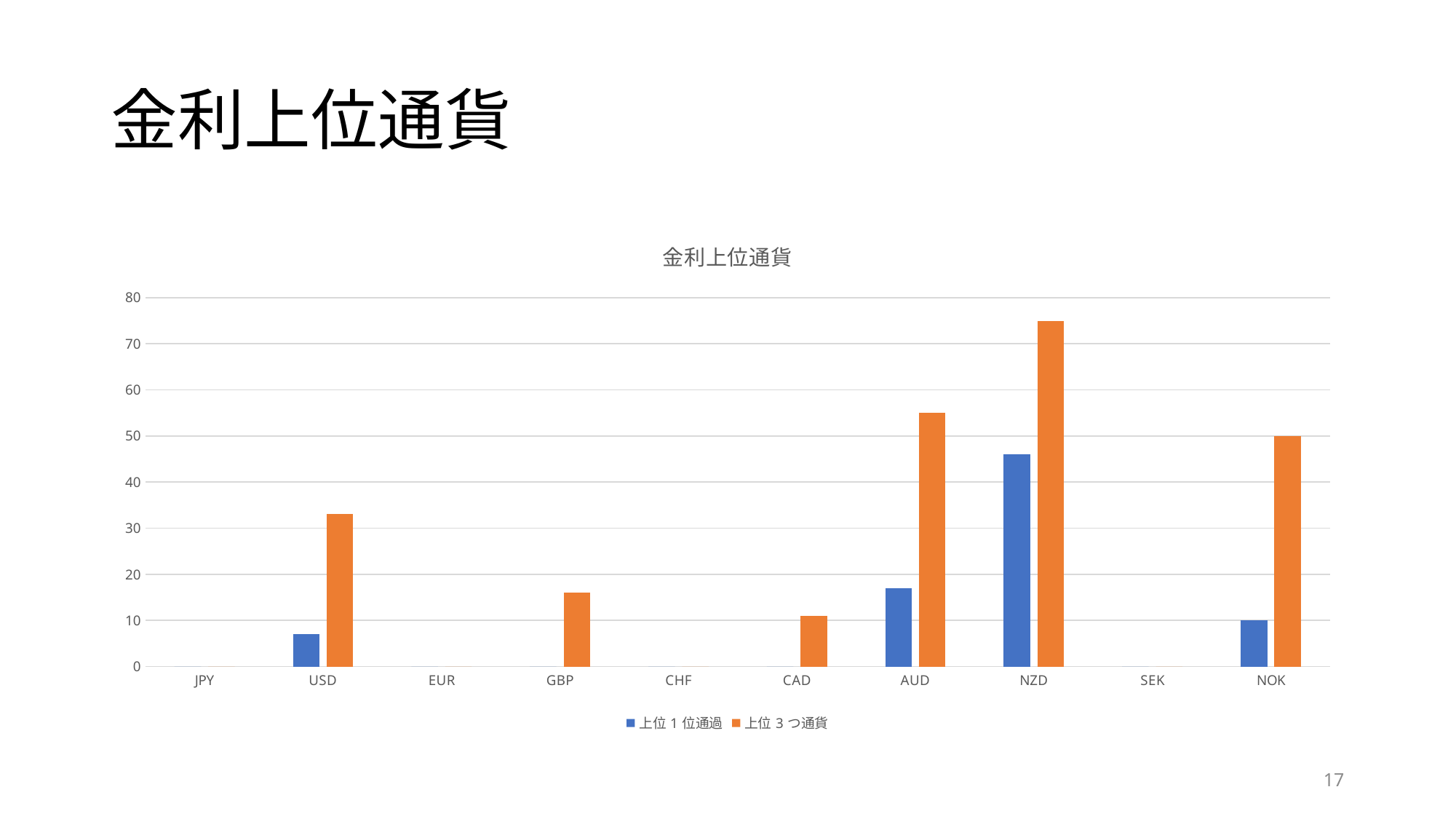
Which currency has the highest value for 上位 1 位通過? NZD Which is larger, the 上位 1 位通過 value for NZD or for AUD? NZD Is the 上位 3 つ通貨 value for USD greater or less than 30? greater How many series does the legend list? 2 What kind of chart is shown on the slide? bar chart Which currency has the highest value for 上位 3 つ通貨? NZD How many currency categories are shown on the x axis? 10 Is the 上位 1 位通過 value for AUD greater or less than 20? less Is the 上位 3 つ通貨 value for NZD greater or less than 70? greater Which is larger, the 上位 3 つ通貨 value for AUD or for NOK? AUD What is the title of the chart? 金利上位通貨 What is the 上位 3 つ通貨 value for NOK? 50